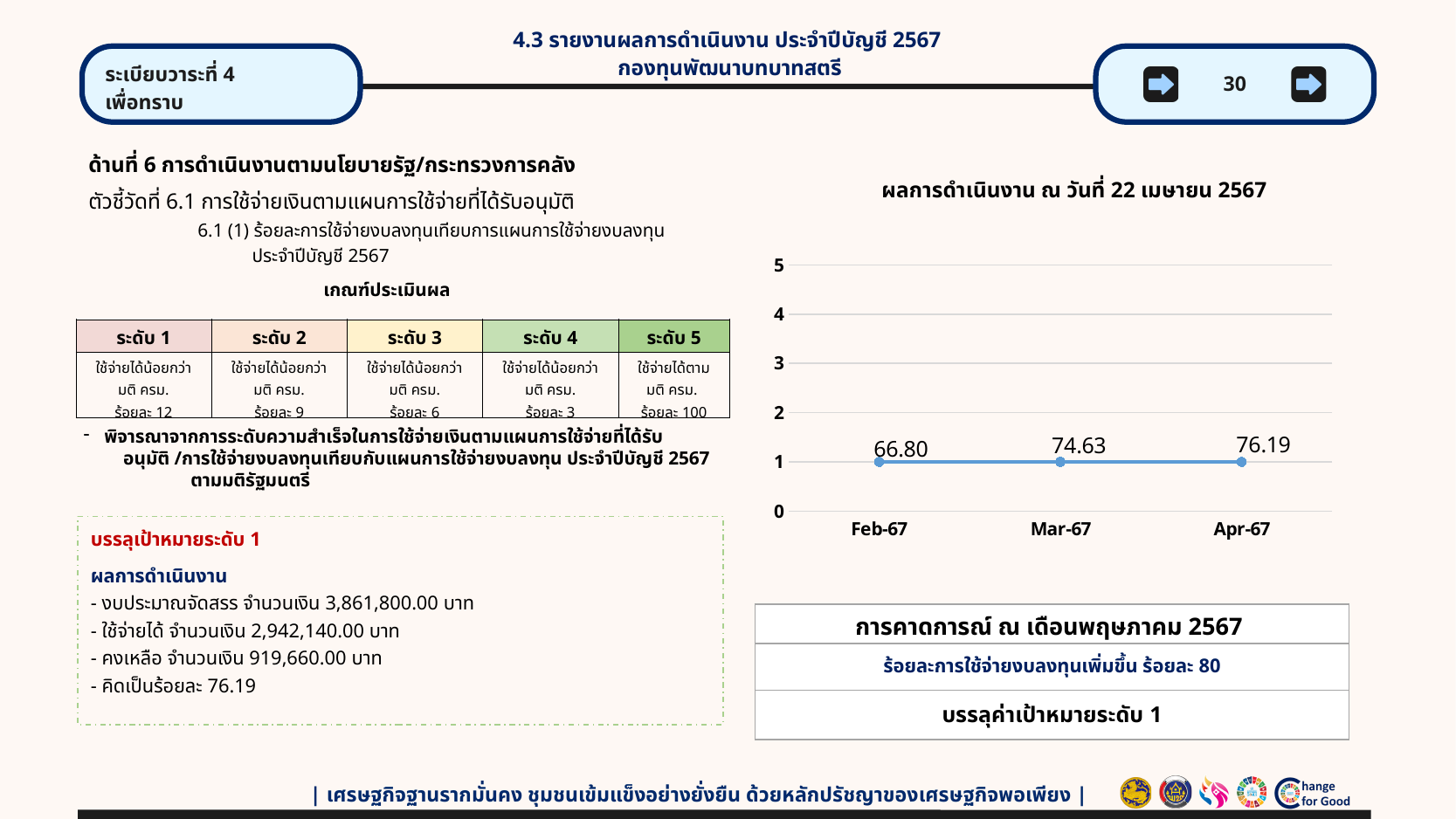
What is the difference between the data labels for Mar-67 and Feb-67? 7.83 What kind of chart is shown on the slide? line chart What is the difference between the data labels for Apr-67 and Feb-67? 9.39 Do the data labels rise or fall from Feb-67 to Apr-67? rise Which is larger, the data label for Mar-67 or for Apr-67? Apr-67 What is the data label for Feb-67 in the chart? 66.80 Which month has the highest data label in the chart? Apr-67 What is the title of the chart? ผลการดำเนินงาน ณ วันที่ 22 เมษายน 2567 How many months are plotted on the x axis of the chart? 3 Which month has the lowest data label in the chart? Feb-67 What is the data label for Mar-67 in the chart? 74.63 What is the data label for Apr-67 in the chart? 76.19